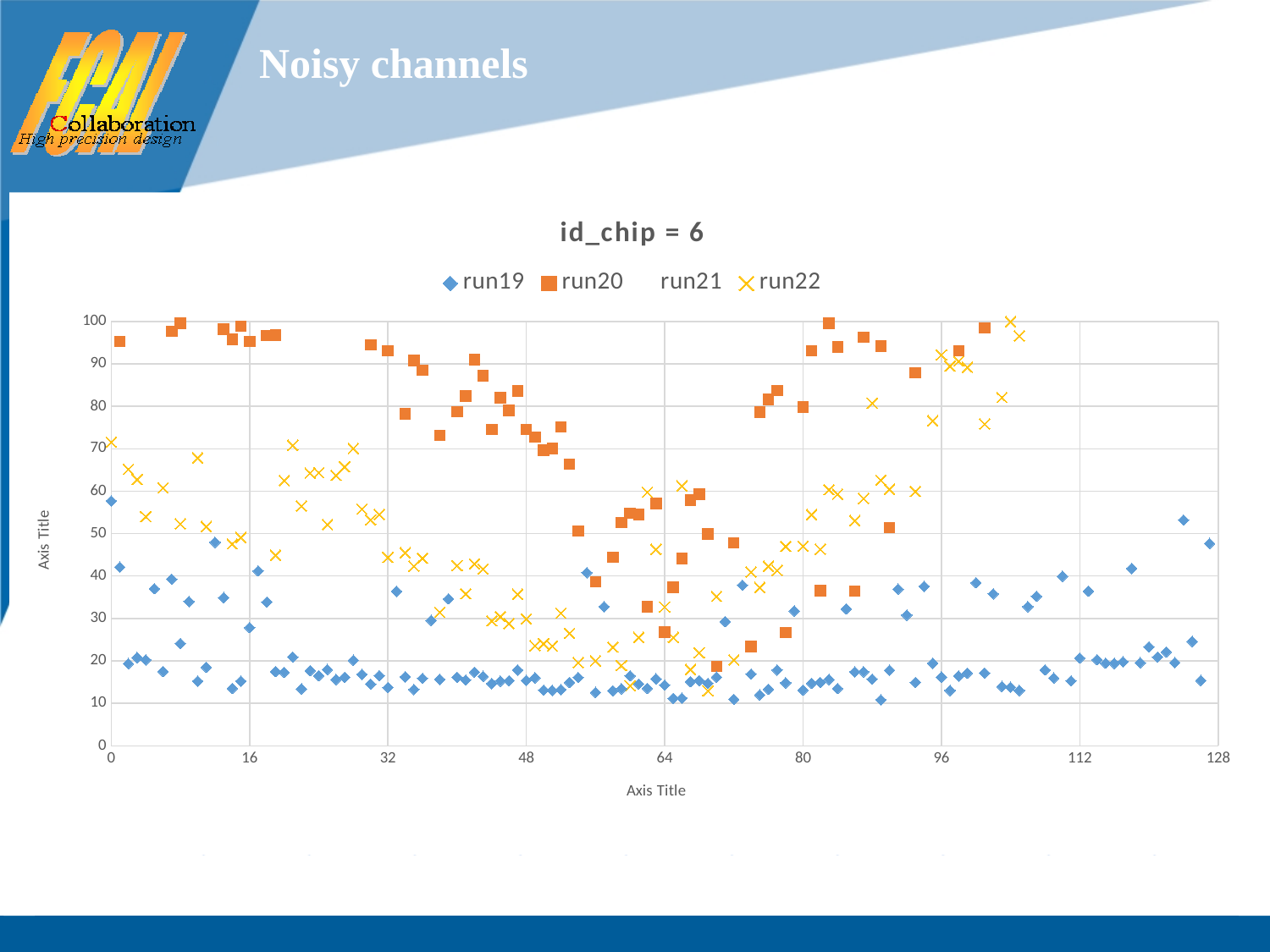
Which series has the lowest plotted values overall? run19 What kind of chart is shown on the slide? scatter chart Is the run22 value at x = 0 greater or less than 60? greater What is the maximum value shown on the x axis? 128 How many tick labels are shown on the x axis? 9 Is the highest plotted run19 value greater or less than 70? less What is the maximum value shown on the y axis? 100 Is the run19 value at x = 0 greater or less than 50? greater How many series does the chart legend list? 4 What are the series names listed in the legend? run19, run20, run21, run22 What is the title of the chart? id_chip = 6